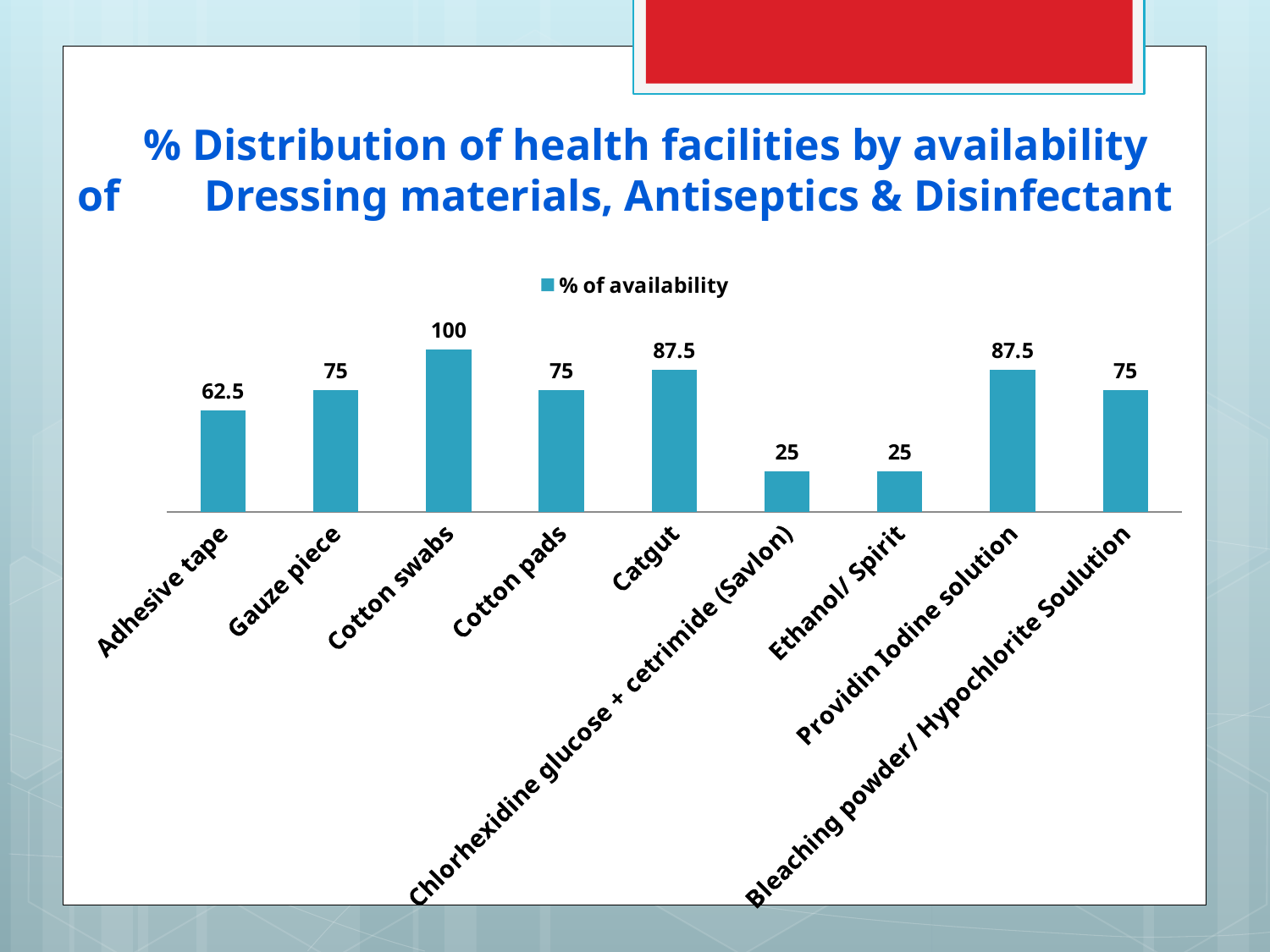
What kind of chart is shown on the slide? Bar chart Which has a higher % of availability, Gauze piece or Adhesive tape? Gauze piece How many series does the legend list? 1 What is the difference in % of availability between Cotton swabs and Adhesive tape? 37.5 Which category has the highest % of availability? Cotton swabs What is the difference in % of availability between Catgut and Ethanol/ Spirit? 62.5 What is the % of availability for Ethanol/ Spirit? 25 What is the % of availability for Providin Iodine solution? 87.5 How many categories are shown on the x axis of the chart? 9 What is the legend entry of the chart? % of availability What is the % of availability for Cotton swabs? 100 What is the % of availability for Adhesive tape? 62.5